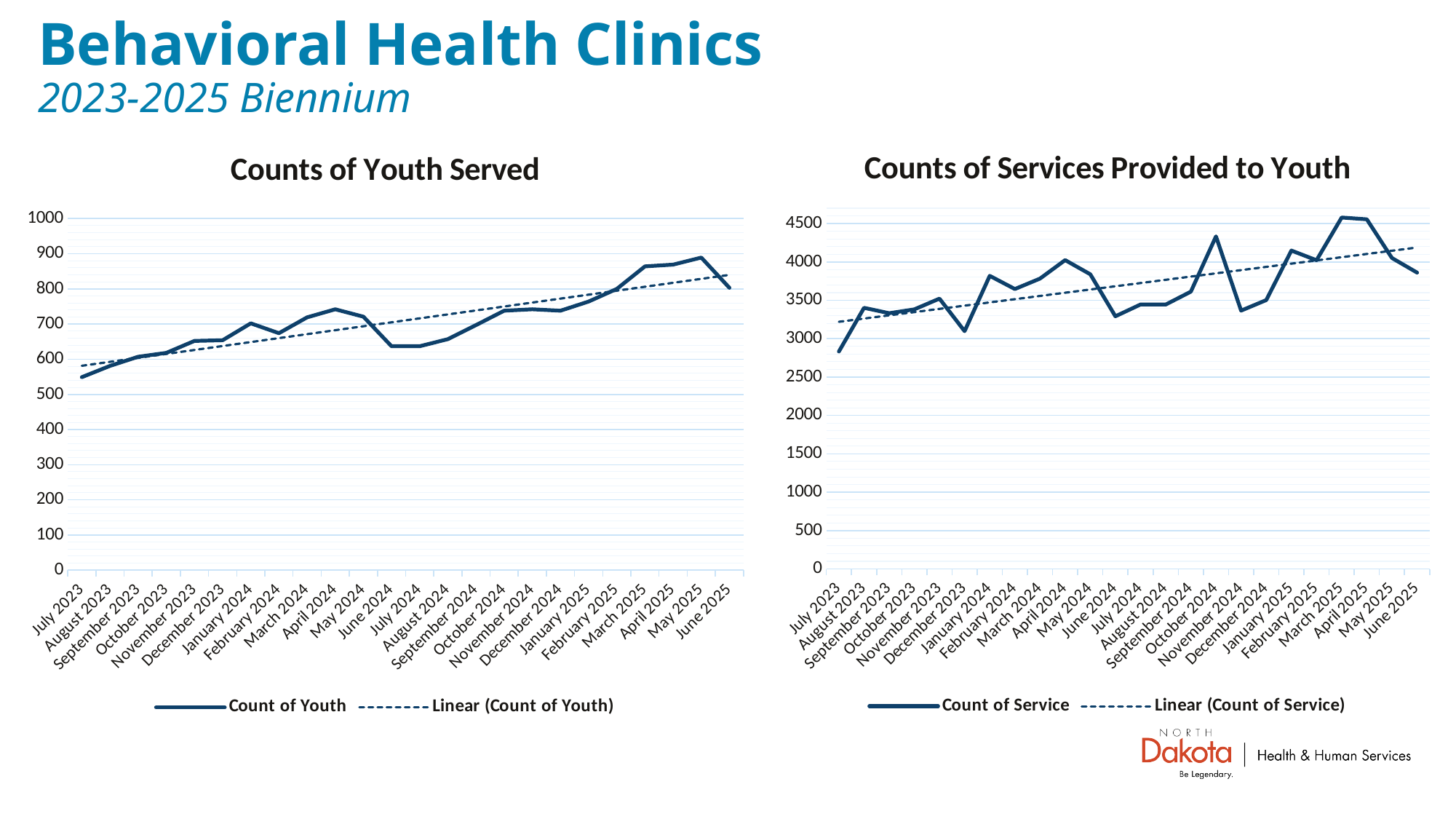
On the "Counts of Services Provided to Youth" chart, is the value for October 2024 greater or less than 4000? greater On the "Counts of Services Provided to Youth" chart, does the linear trend line rise or fall from July 2023 to June 2025? rise On the "Counts of Youth Served" chart, which month has the lowest count of youth? July 2023 How many monthly data points are plotted on the "Counts of Youth Served" chart? 24 On the "Counts of Youth Served" chart, is the value for March 2025 greater or less than 800? greater What kind of chart is the "Counts of Youth Served" chart? line chart On the "Counts of Services Provided to Youth" chart, which month has the lowest count of service? July 2023 What is the name of the dashed series in the legend of the "Counts of Youth Served" chart? Linear (Count of Youth) On the "Counts of Youth Served" chart, is the value for July 2023 greater or less than 600? less On the "Counts of Services Provided to Youth" chart, which is larger, the value for October 2024 or the value for November 2024? October 2024 On the "Counts of Youth Served" chart, which month has the highest count of youth? May 2025 How many entries does the legend of the "Counts of Services Provided to Youth" chart list? 2